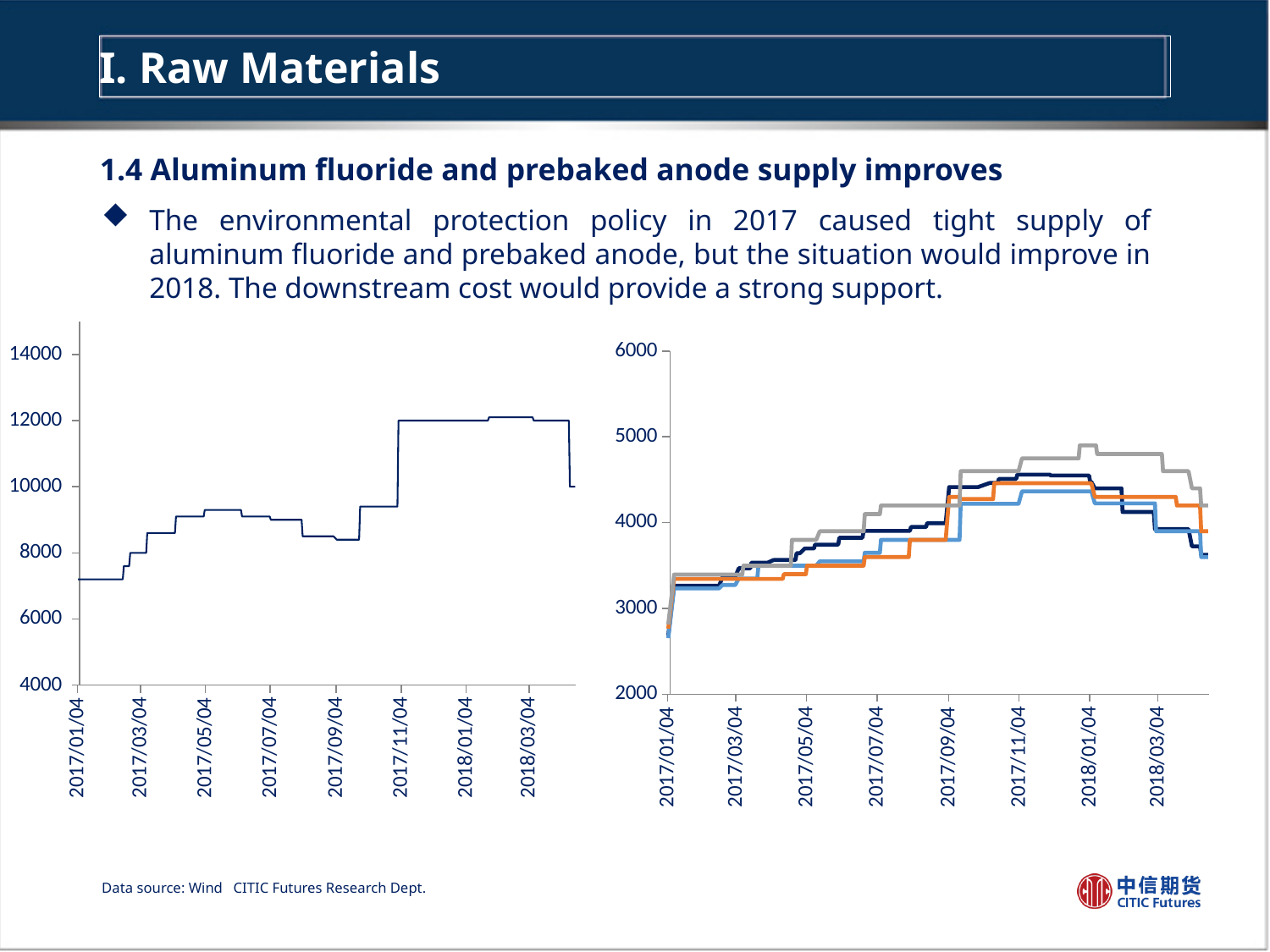
On the left chart, is the value at 2017/05/04 greater or less than 8000? greater On the right chart, which line is highest at 2018/01/04? the gray line On the right chart, do the values rise or fall between 2017/03/04 and 2017/11/04? rise How many lines are plotted on the right chart? 4 What kind of chart is the chart on the right of the slide? line chart On the left chart, is the value at 2017/01/04 greater or less than 8000? less What kind of chart is the chart on the left of the slide? line chart On the right chart, is the gray line's value at 2018/01/04 greater or less than 4000? greater How many date labels are shown on the x axis of the left chart? 8 On the left chart, is the value at 2018/01/04 larger or smaller than the value at 2017/01/04? larger